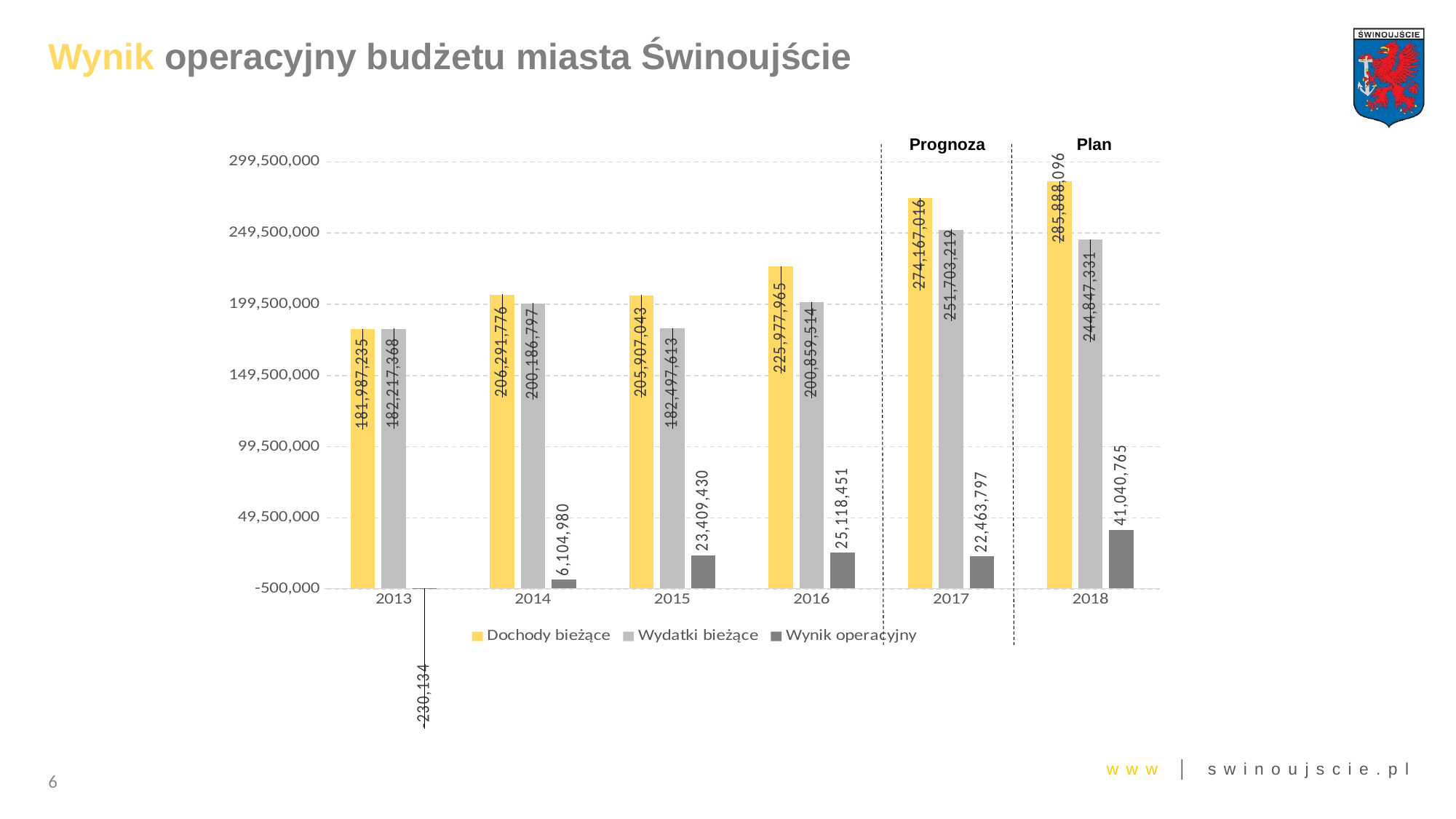
What is the Wynik operacyjny for 2018? 41,040,765 What type of chart is shown on the slide? Bar chart What is the difference between Wynik operacyjny in 2016 and in 2015? 1,709,021 Which years are marked as 'Prognoza' and 'Plan' on the chart? 2017 (Prognoza) and 2018 (Plan) What is the value of Dochody bieżące for 2016? 225,977,965 How many years are shown on the x axis? 6 What is the Wynik operacyjny for 2013? -230,134 In which year is Dochody bieżące the lowest? 2013 Which is larger in 2014: Dochody bieżące or Wydatki bieżące? Dochody bieżące In which year is Wynik operacyjny the highest? 2018 What is the value of Wydatki bieżące for 2017? 251,703,219 How many series does the legend list? 3